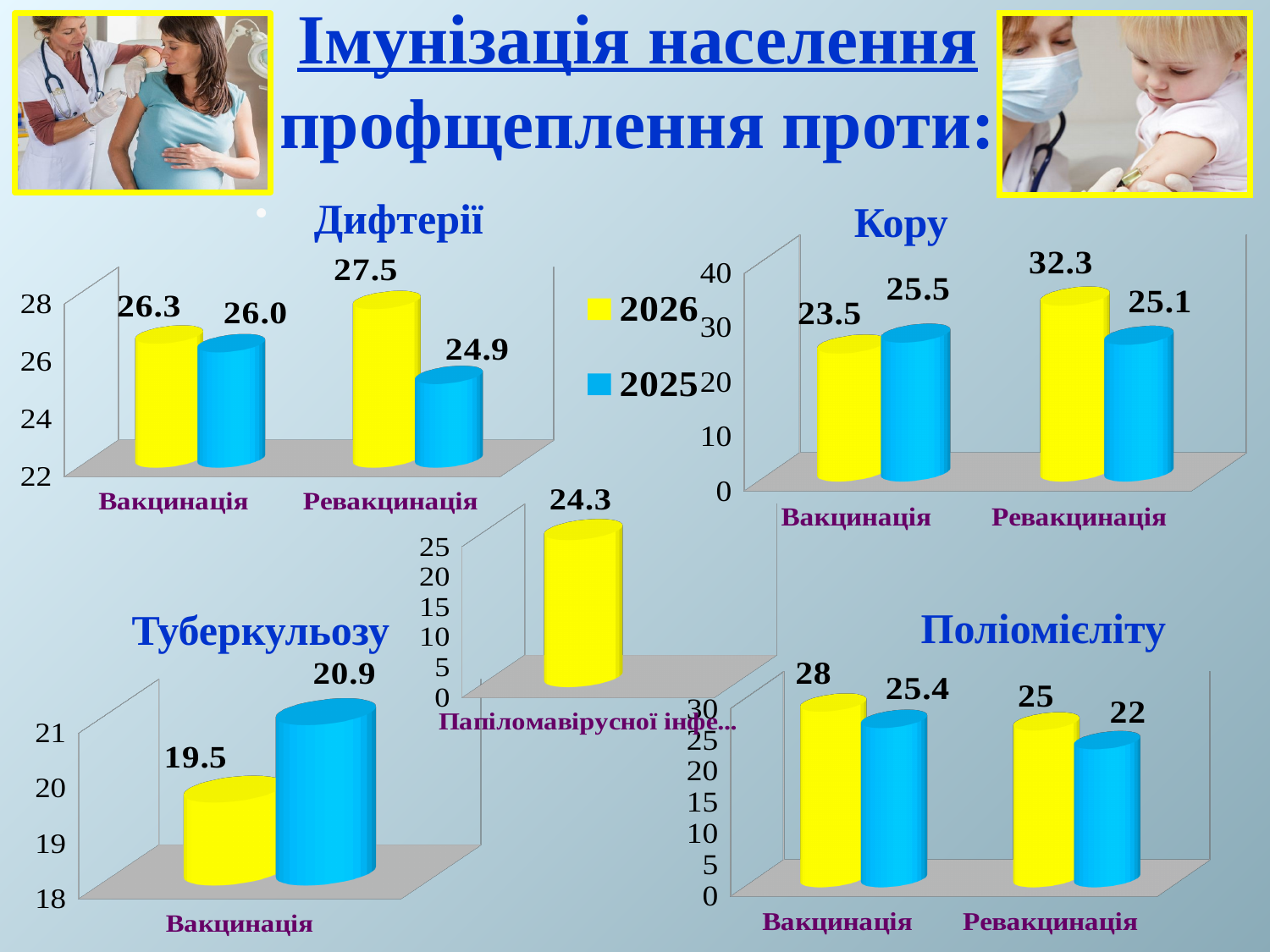
How many series does the legend on the slide list? 2 In the 'Туберкульозу' chart, which year has the larger value for Вакцинація, 2026 or 2025? 2025 In the 'Кору' chart, what is the difference between the 2025 and 2026 values for Вакцинація? 2.0 In the 'Туберкульозу' chart, what is the 2025 value for Вакцинація? 20.9 In the chart for 'Папіломавірусної інфе...', what value is shown on the bar? 24.3 In the 'Поліомієліту' chart, what is the difference between the 2026 and 2025 values for Вакцинація? 2.6 In the 'Кору' chart, which category and series has the highest value? Ревакцинація, 2026 What kind of chart is the 'Дифтерії' chart? Bar chart In the 'Дифтерії' chart, what is the 2026 value for Ревакцинація? 27.5 In the 'Кору' chart, what is the 2026 value for Ревакцинація? 32.3 In the 'Дифтерії' chart, what is the 2025 value for Вакцинація? 26.0 In the 'Поліомієліту' chart, what is the 2025 value for Ревакцинація? 22